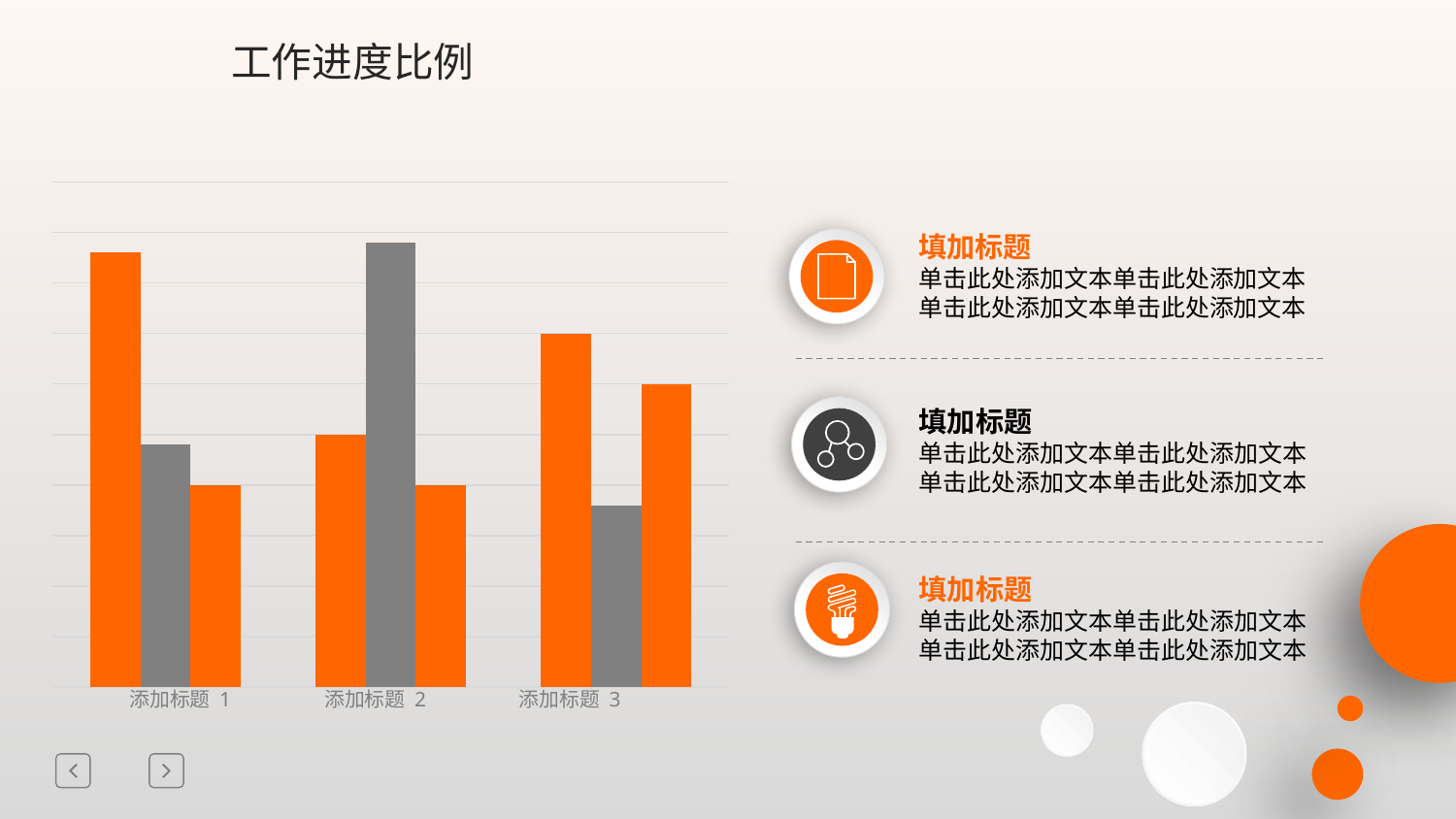
In the category 添加标题 1, is the left bar or the right bar taller? The left bar How many bars are plotted for each category in the chart? 3 What kind of chart is shown on the slide? Bar chart In the category 添加标题 3, which bar is the shortest? The middle (gray) bar Which category has the tallest left-hand orange bar? 添加标题 1 What is the title of the slide containing the chart? 工作进度比例 Which colours are used for the bars in the chart? Orange and gray Which category has the shortest gray bar? 添加标题 3 In the category 添加标题 1, which bar is the tallest? The left (orange) bar Which category has the tallest gray bar? 添加标题 2 How many categories are shown on the x axis of the chart? 3